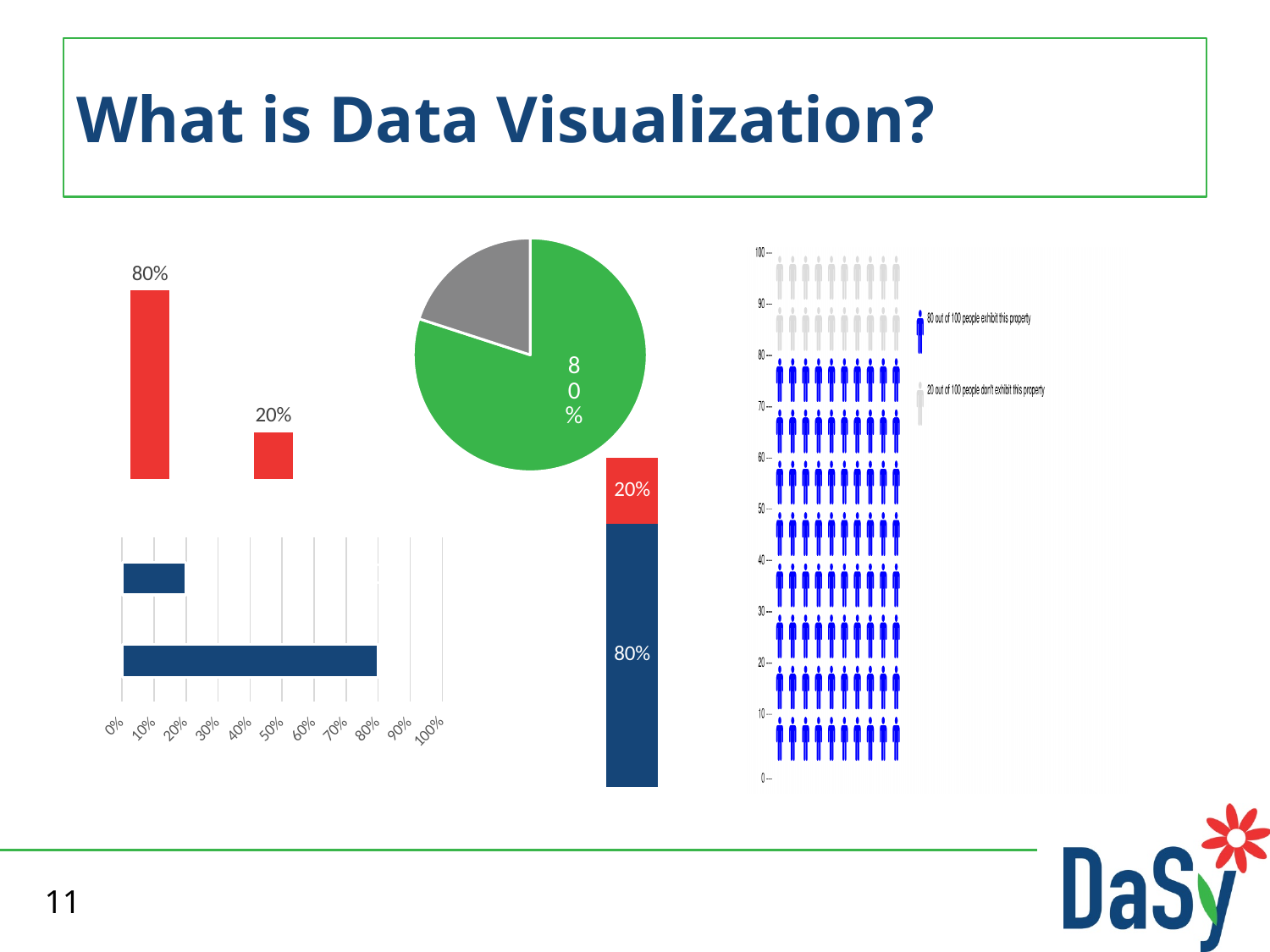
In the horizontal bar chart at the bottom left, is the value of the upper (shorter) bar greater or less than 50%? less In the red vertical bar chart at the top left, what value is labelled on the shorter bar? 20% In the pie chart, which slice is larger, the green one or the grey one? green In the red vertical bar chart at the top left, what value is labelled on the taller bar? 80% What kind of chart is the chart at the bottom left of the slide with the 0% to 100% axis? bar chart In the horizontal bar chart at the bottom left, is the value of the lower (longer) bar greater or less than 50%? greater In the pictogram chart on the right, according to the legend, how many out of 100 people exhibit this property? 80 out of 100 In the stacked bar in the centre of the slide, what is the total of the two labelled segments? 100% In the red vertical bar chart at the top left, how many bars are plotted? 2 In the stacked bar in the centre of the slide, what value is labelled on the red segment? 20% In the red vertical bar chart at the top left, what is the difference between the two labelled bar values? 60% In the pie chart, what value is labelled on the green slice? 80%